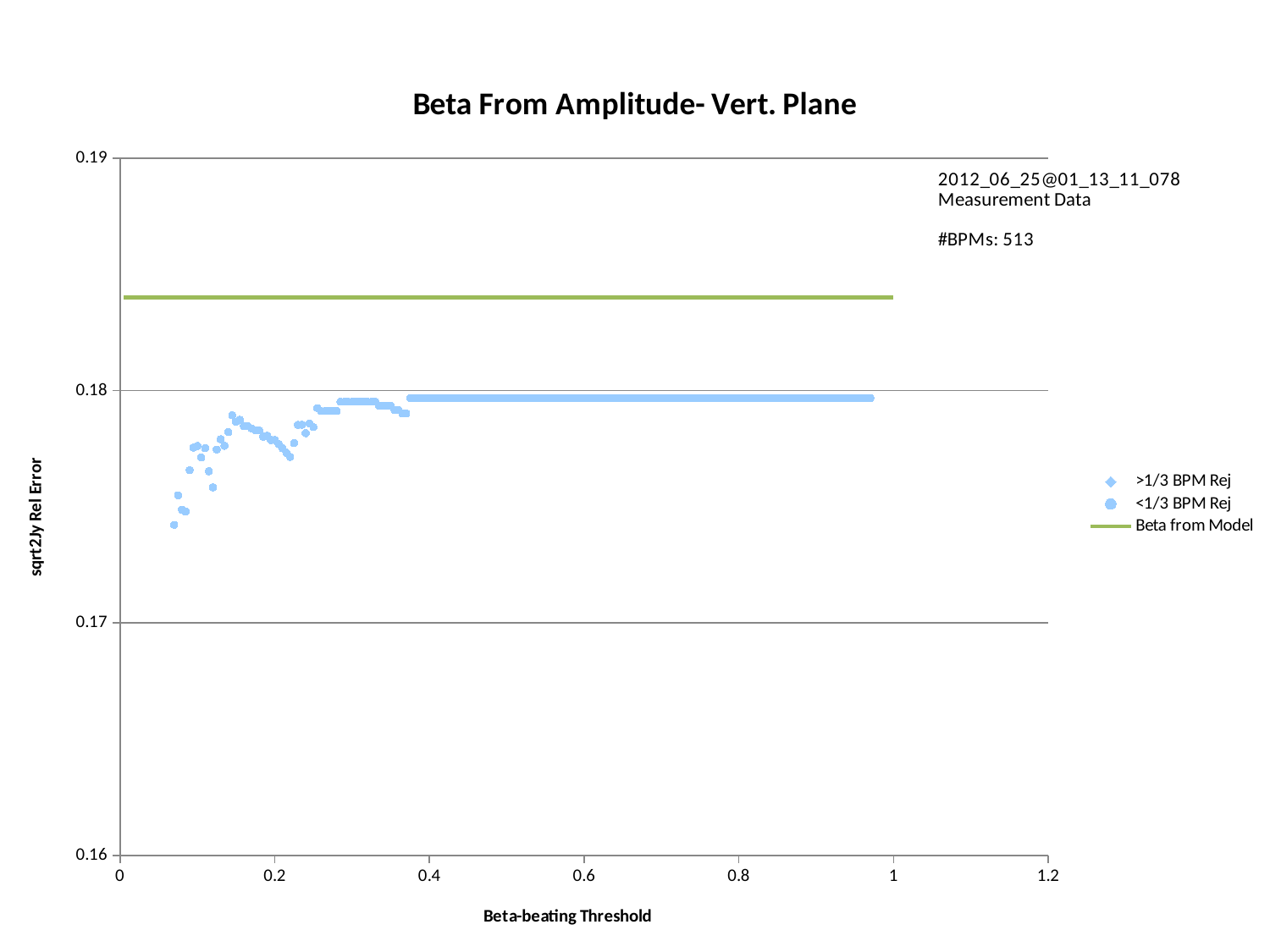
Is the value of the Beta from Model line greater or less than 0.18? greater Is the value of the measured points at Beta-beating Threshold 0.8 greater or less than 0.17? greater What is the title of the chart? Beta From Amplitude- Vert. Plane Is the lowest measured point (near Beta-beating Threshold 0.07) greater or less than 0.17? greater How many series does the chart's legend list? 3 Do the measured points generally rise or fall as Beta-beating Threshold increases from about 0.07 to 0.4? rise Which is higher on the chart: the Beta from Model line or the measured <1/3 BPM Rej points? Beta from Model What is the label of the x axis? Beta-beating Threshold Does the Beta from Model line rise, fall, or stay flat as Beta-beating Threshold increases? stay flat What kind of chart is shown on the slide? scatter chart